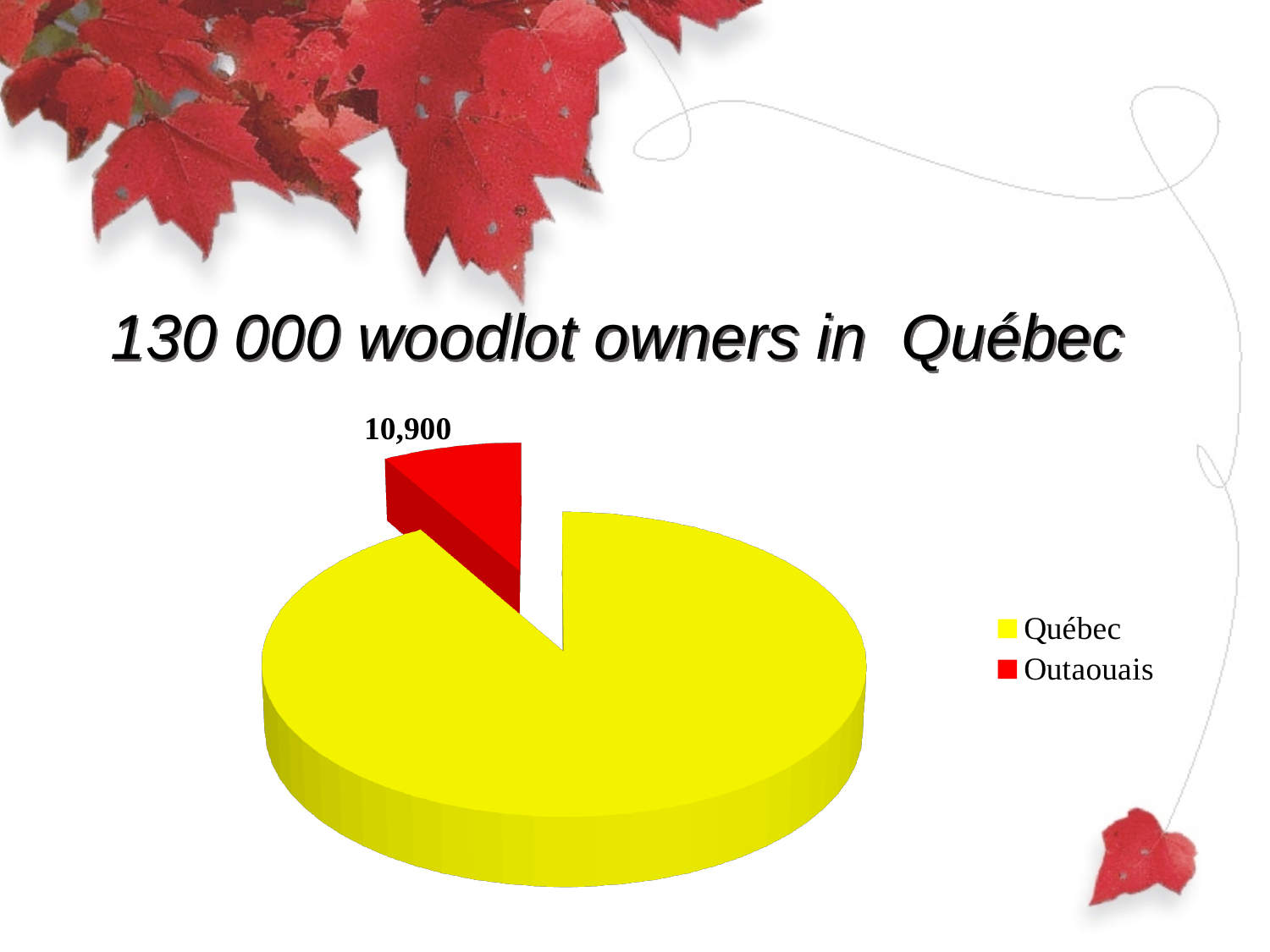
Which category has the largest slice in the pie chart? Québec What is the title shown above the pie chart? 130 000 woodlot owners in Québec Which category has the smallest slice in the pie chart? Outaouais What colour is the Outaouais slice in the pie chart? Red How many entries does the legend of the pie chart list? 2 What value is shown for the Outaouais slice of the pie chart? 10,900 How many slices does the pie chart have? 2 What kind of chart is shown on the slide? Pie chart Which slice is larger in the pie chart, Québec or Outaouais? Québec